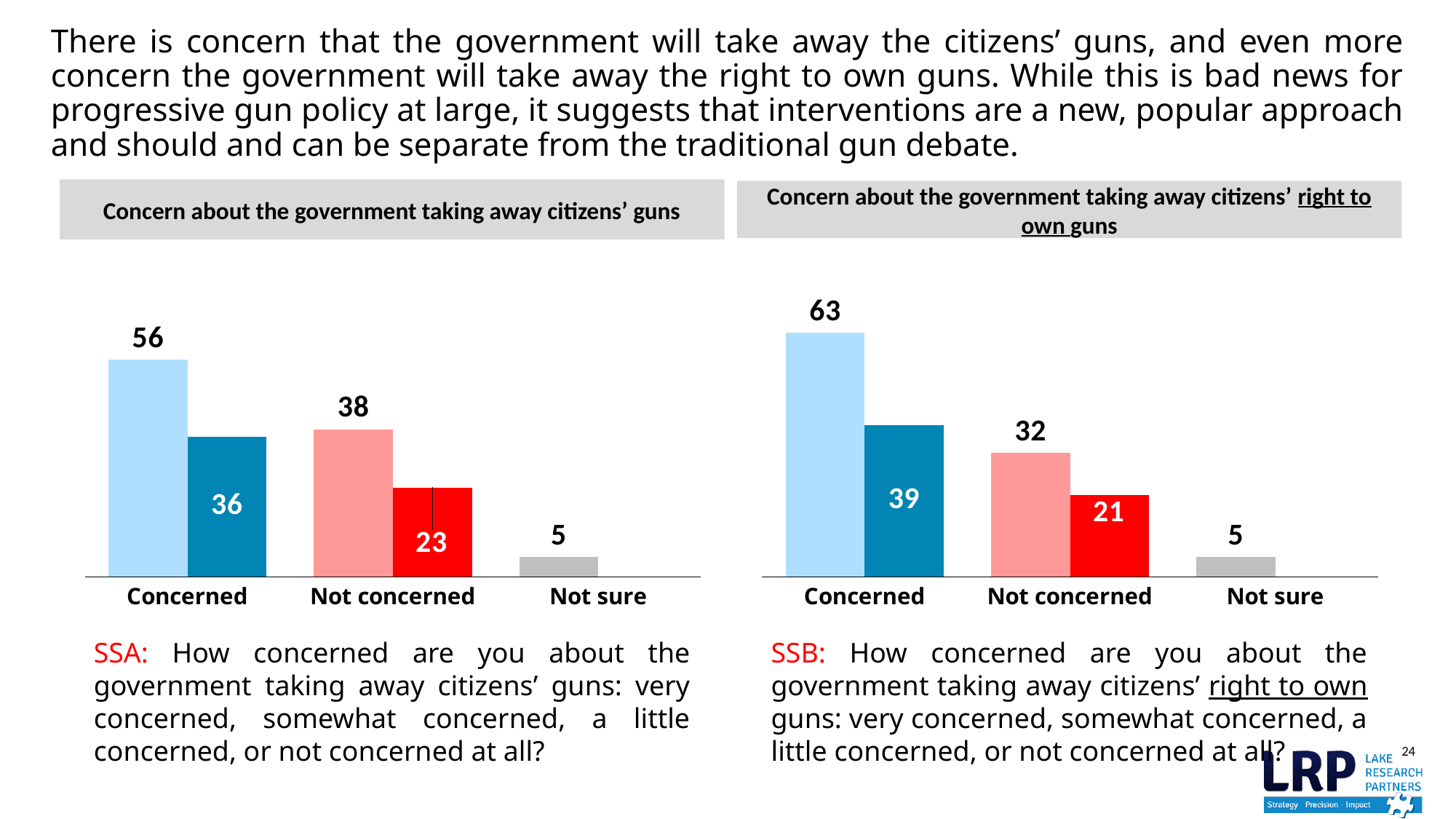
In the left chart, 'Concern about the government taking away citizens' guns', what is the value of the light blue bar for Concerned? 56 In the right chart, 'Concern about the government taking away citizens' right to own guns', which bar has the highest value? Concerned (63) Which is larger: the light blue Concerned bar in the left chart or the light blue Concerned bar in the right chart? The right chart (63) In the left chart, 'Concern about the government taking away citizens' guns', what is the value of the dark blue bar for Concerned? 36 In the left chart, 'Concern about the government taking away citizens' guns', what is the difference between the light blue Concerned bar (56) and the light red Not concerned bar (38)? 18 In the right chart, 'Concern about the government taking away citizens' right to own guns', what is the value of the light red bar for Not concerned? 32 In the right chart, 'Concern about the government taking away citizens' right to own guns', what is the value of the light blue bar for Concerned? 63 In the right chart, 'Concern about the government taking away citizens' right to own guns', what is the value for Not sure? 5 What type of chart is used on this slide? Bar chart In the left chart, 'Concern about the government taking away citizens' guns', which category has the lowest value? Not sure In the right chart, 'Concern about the government taking away citizens' right to own guns', what is the difference between the light blue Concerned bar (63) and the dark blue Concerned bar (39)? 24 In the left chart, 'Concern about the government taking away citizens' guns', what is the value of the bright red bar for Not concerned? 23